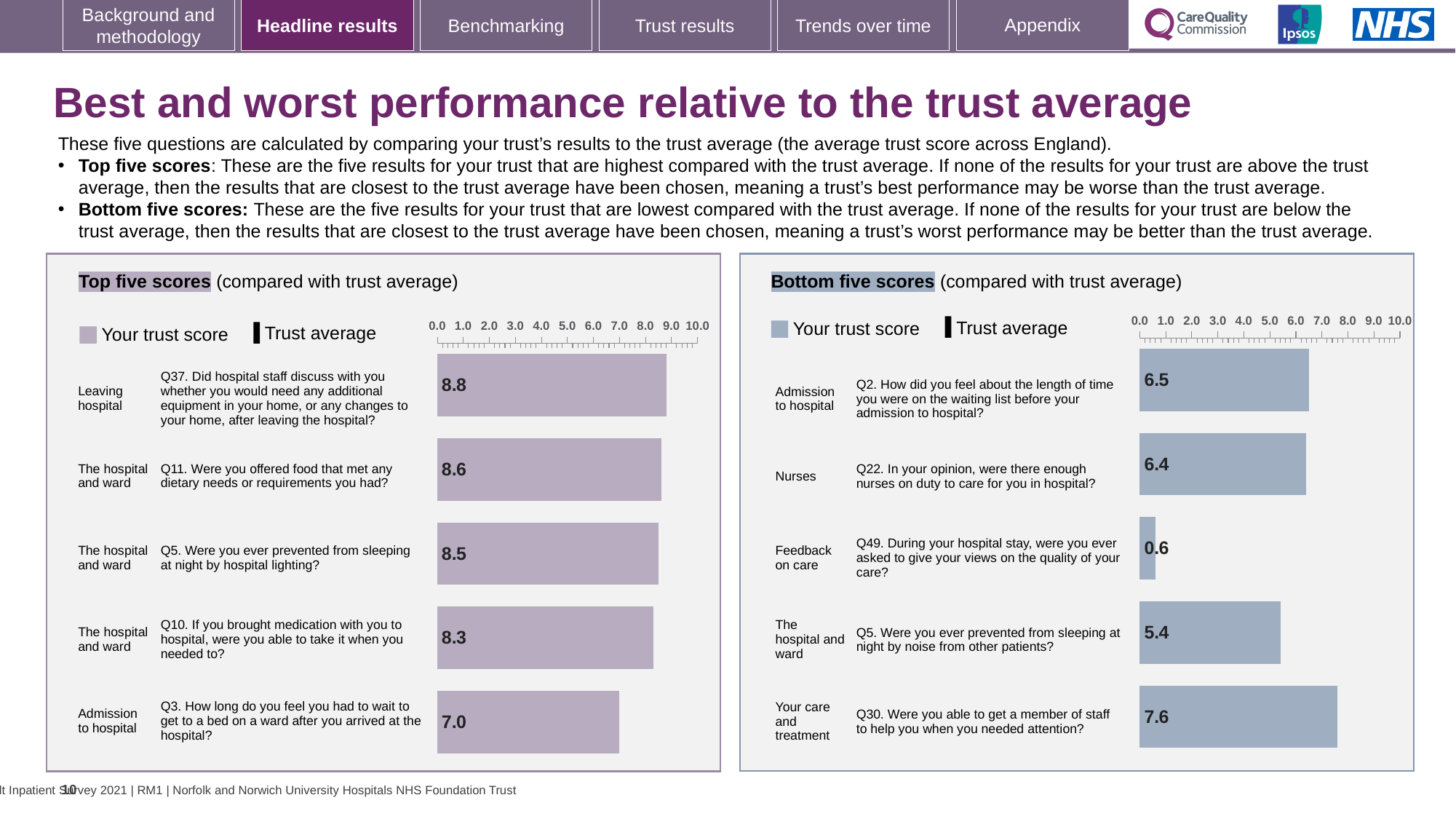
What two entries does the legend of the 'Top five scores' chart list? Your trust score; Trust average What type of chart is used in the 'Bottom five scores' panel? Bar chart In the 'Bottom five scores' chart, what is the difference between the trust scores for Q30 and Q5? 2.2 In the 'Top five scores' chart, what is the trust score for Q3 (How long do you feel you had to wait to get to a bed on a ward after you arrived at the hospital?)? 7.0 How many bars are shown in the 'Top five scores' chart? 5 In the 'Bottom five scores' chart, what is the trust score for Q49 (During your hospital stay, were you ever asked to give your views on the quality of your care?)? 0.6 In the 'Top five scores' chart, which question has the highest trust score? Q37 (8.8) In the 'Top five scores' chart, what is the trust score for Q11 (Were you offered food that met any dietary needs or requirements you had?)? 8.6 In the 'Bottom five scores' chart, which question has the lowest trust score? Q49 (0.6) In the 'Top five scores' chart, what is the difference between the trust scores for Q37 and Q3? 1.8 In the 'Bottom five scores' chart, which question has the highest trust score? Q30 (7.6) In the 'Bottom five scores' chart, which has the larger trust score: Q2 or Q30? Q30